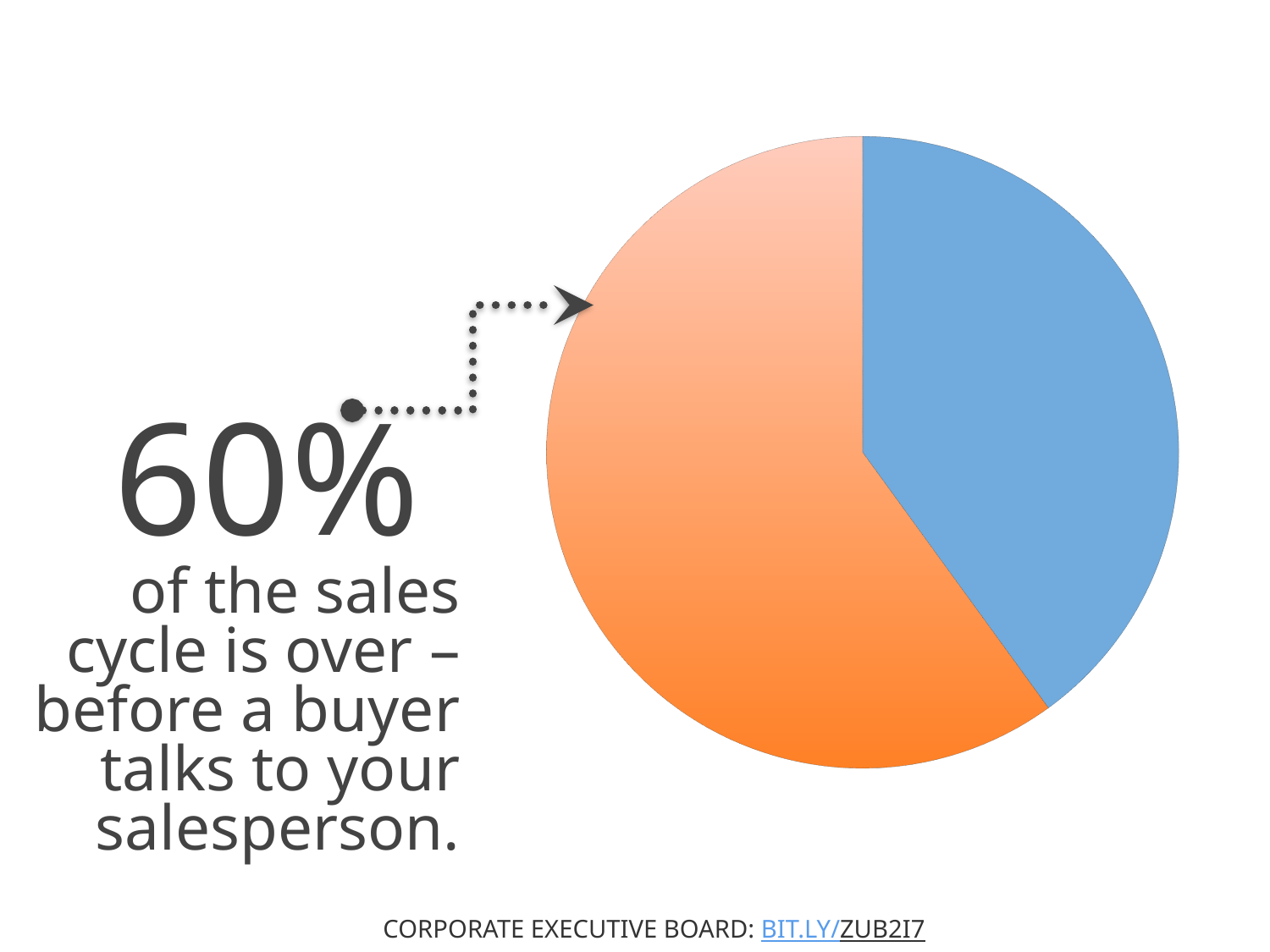
Which slice of the pie is larger, the orange one or the blue one? orange Which slice of the pie does the dotted arrow from the 60% figure point to? the orange slice What share of the pie does the orange slice represent? 60% Is the blue slice of the pie greater or less than half of the pie? less Which slice of the pie chart is the smallest? the blue slice According to the slide, what does the 60% slice represent? the share of the sales cycle that is over before a buyer talks to your salesperson What share of the pie does the blue slice represent? 40% Which slice of the pie chart is the largest? the orange slice How many slices does the pie chart have? 2 What kind of chart is shown on the slide? pie chart